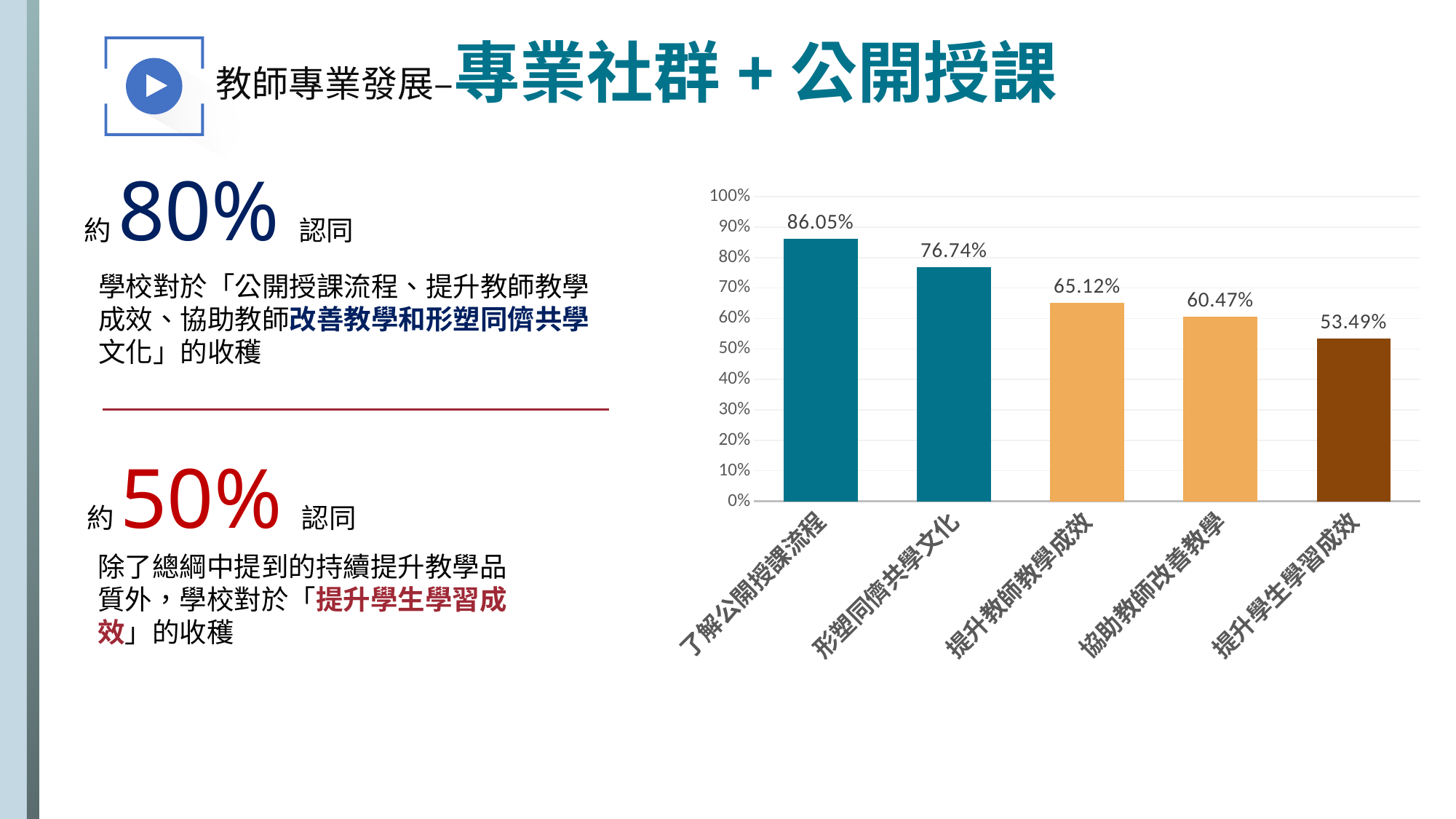
Which is larger, the value for 形塑同儕共學文化 or the value for 協助教師改善教學? 形塑同儕共學文化 What is the value for 協助教師改善教學? 60.47% How many categories are shown in the chart? 5 What is the value for 提升學生學習成效? 53.49% What is the difference between the values for 了解公開授課流程 and 提升學生學習成效? 32.56% Which category has the lowest value? 提升學生學習成效 Do the values rise or fall from left to right along the x axis? fall Which category has the highest value? 了解公開授課流程 What is the value for 形塑同儕共學文化? 76.74% What is the value for 了解公開授課流程? 86.05% What is the value for 提升教師教學成效? 65.12% What kind of chart is shown on the slide? bar chart